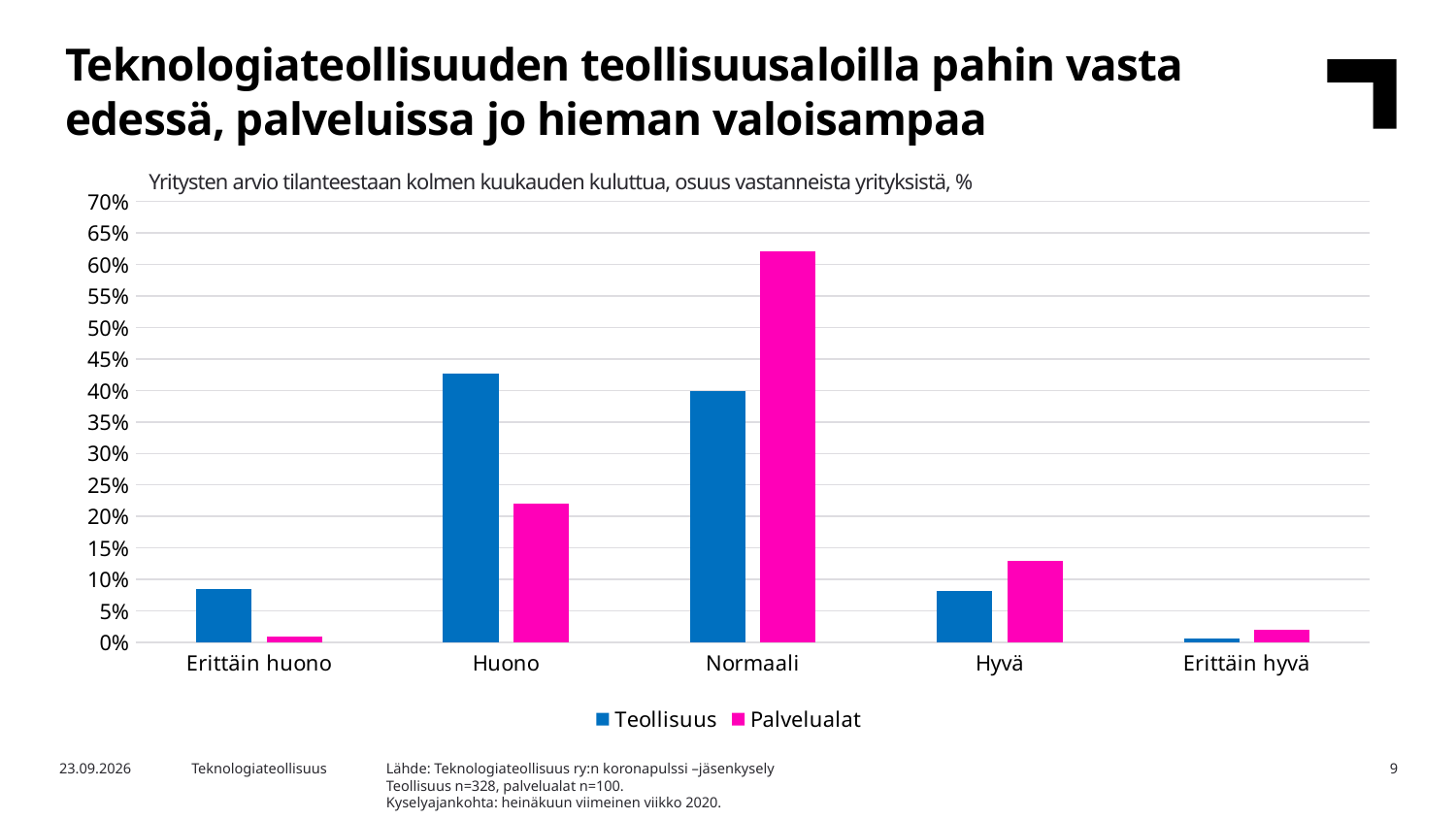
Is the Palvelualat value for Huono greater or less than 25%? less What kind of chart is shown on the slide? bar chart For the Normaali category, which series has the larger value, Teollisuus or Palvelualat? Palvelualat Which category has the highest value for the Palvelualat series? Normaali Is the Palvelualat value for Normaali greater or less than 55%? greater Is the Teollisuus value for Huono greater or less than 35%? greater How many series does the chart's legend list? 2 Which category has the lowest value for the Teollisuus series? Erittäin hyvä For the Huono category, which series has the larger value, Teollisuus or Palvelualat? Teollisuus Which category has the highest value for the Teollisuus series? Huono How many categories are shown on the x axis of the chart? 5 Which colour represents the Palvelualat series in the chart? magenta (pink)